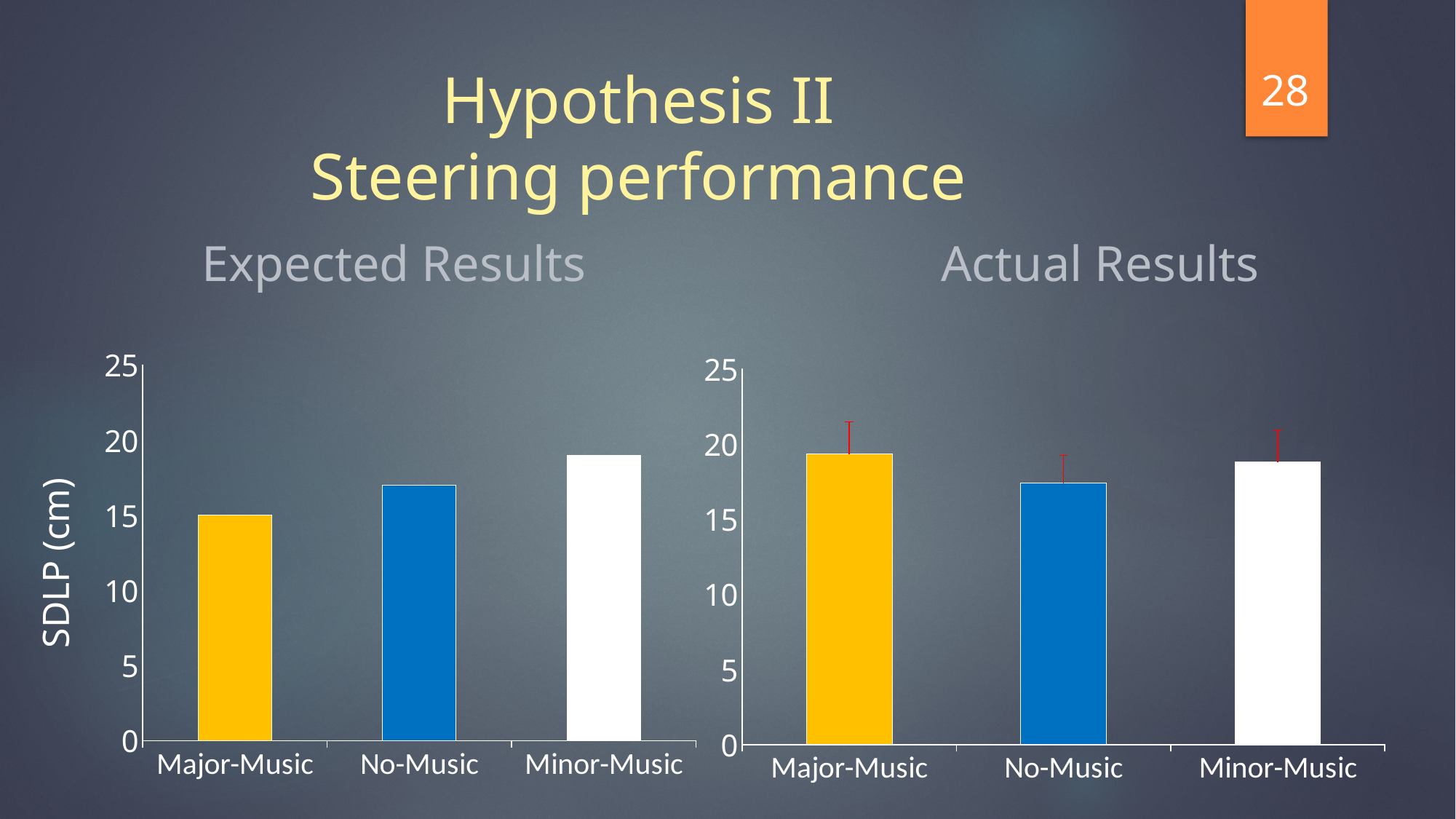
In the Actual Results chart, is the value for Major-Music greater or less than 15? greater In the Expected Results chart, do the values rise or fall from Major-Music to Minor-Music? rise How many categories are shown on the Expected Results chart? 3 What kind of chart is the Expected Results chart? bar chart In the Actual Results chart, which category has the lowest SDLP? No-Music In the Actual Results chart, which is larger, the value for Major-Music or the value for No-Music? Major-Music What is the y-axis label on the Expected Results chart? SDLP (cm) In the Expected Results chart, is the value for Minor-Music greater or less than 20? less In the Expected Results chart, which category has the lowest SDLP? Major-Music In the Expected Results chart, is the value for No-Music greater or less than 15? greater In the Expected Results chart, which is larger, the value for No-Music or the value for Minor-Music? Minor-Music In the Expected Results chart, which category has the highest SDLP? Minor-Music